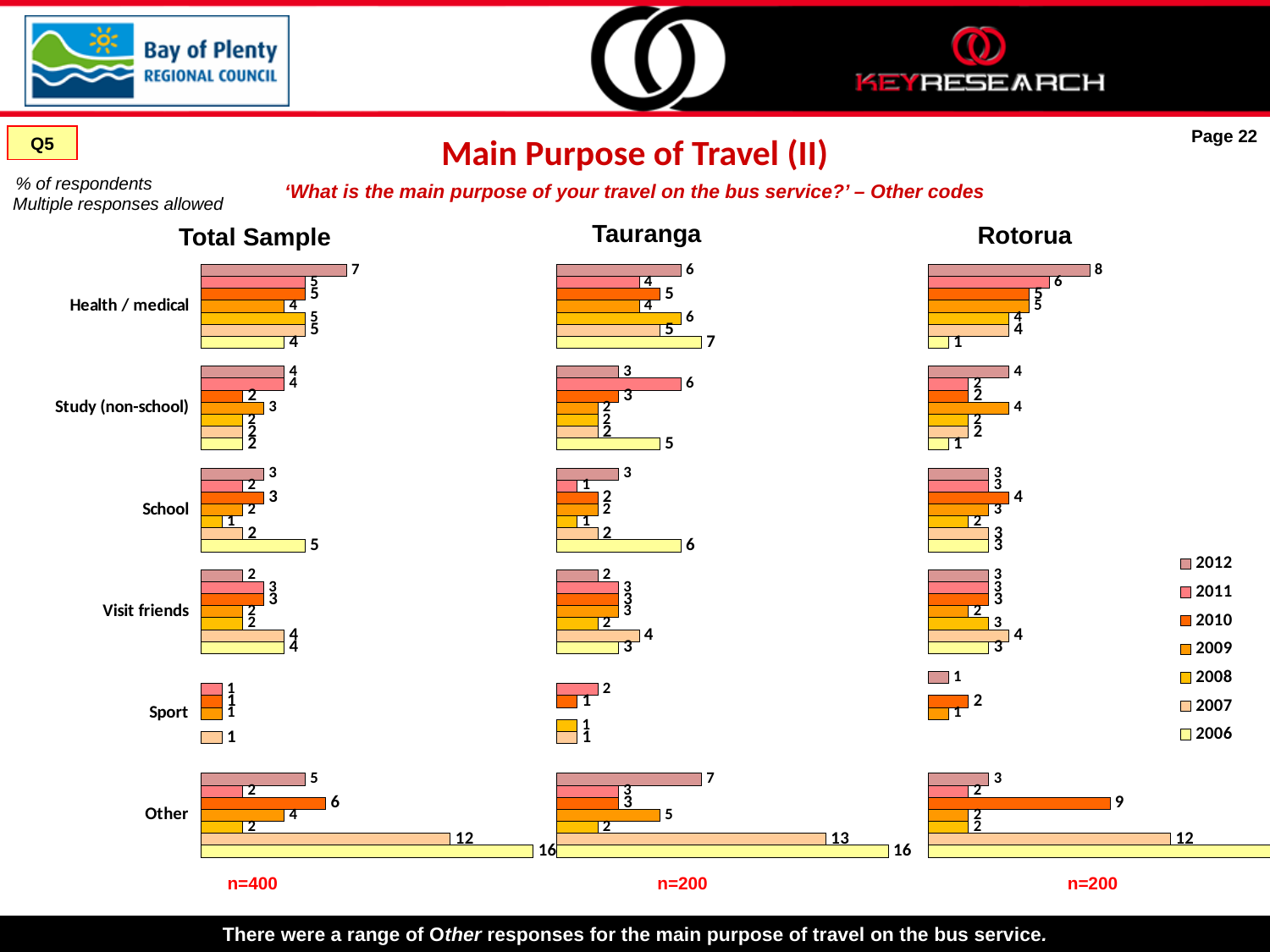
In the Tauranga chart, what is the value for Other in 2006? 16 In the Rotorua chart, what is the value for Health / medical in 2012? 8 How many series (years) does the legend list? 7 In the Rotorua chart, which is larger for Other: the 2010 value or the 2012 value? 2010 In the Total Sample chart, what is the difference between the Other values for 2006 and 2007? 4 What is the sample size (n) shown under the Total Sample chart? n=400 In the Total Sample chart, which year has the highest value for Other? 2006 In the Rotorua chart, what is the value for Study (non-school) in 2012? 4 In the Tauranga chart, what is the value for Health / medical in 2006? 7 What kind of chart is used for the Total Sample data? Bar chart How many purpose-of-travel categories are shown in the Tauranga chart? 6 In the Total Sample chart, what is the value for Health / medical in 2012? 7